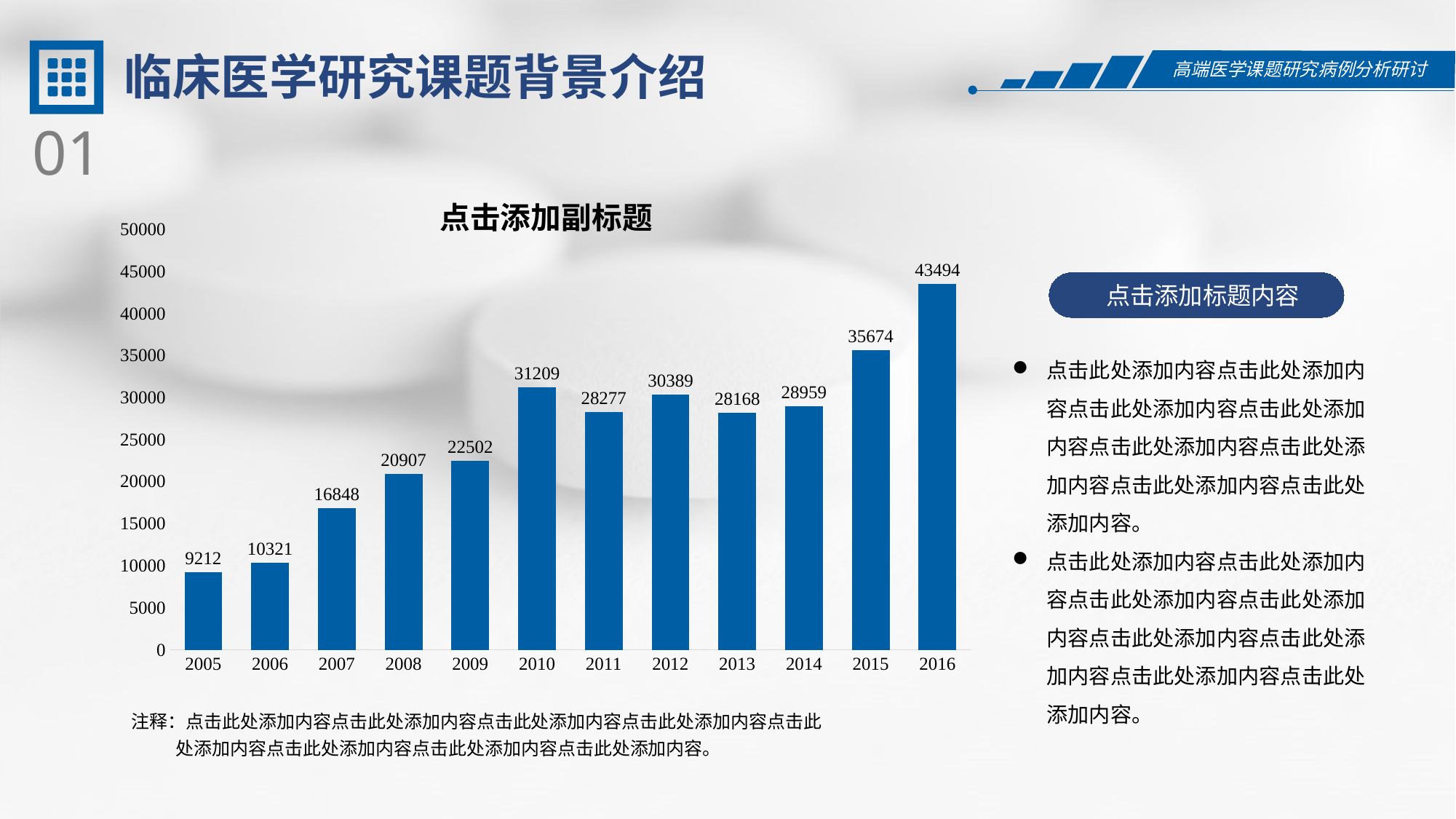
What kind of chart is shown on the slide? bar chart What is the difference between the values for 2016 and 2015? 7820 What is the title of the chart? 点击添加副标题 Which year has the lowest value? 2005 What is the difference between the values for 2007 and 2006? 6527 How many years are shown on the x axis? 12 Which is larger, the value for 2010 or the value for 2012? 2010 What is the value for 2010? 31209 Is the value for 2009 greater or less than 25000? less Which year has the highest value? 2016 What is the value for 2013? 28168 What is the value for 2005? 9212